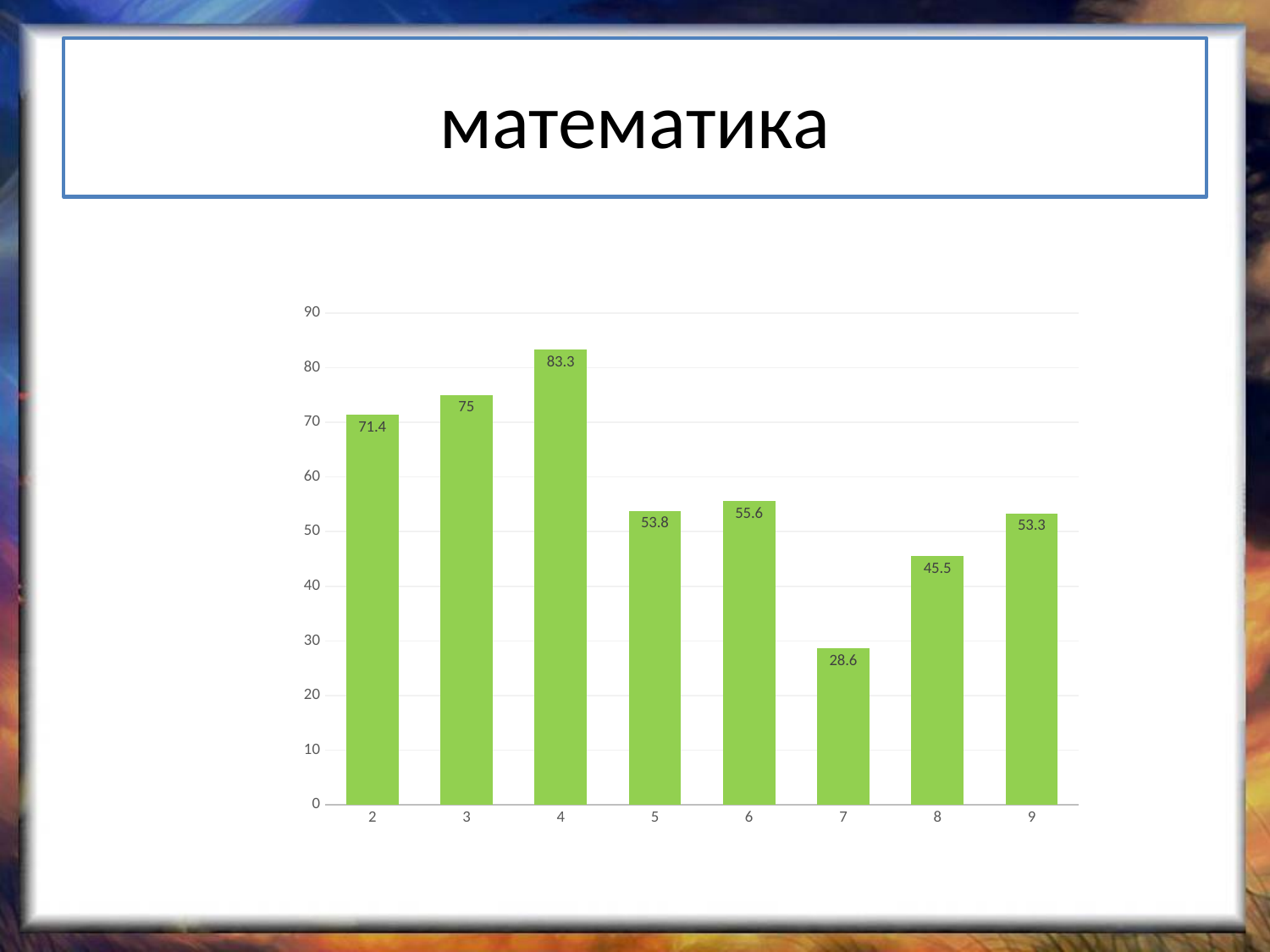
What is the value for category 7? 28.6 Is the value for category 9 greater or less than 50? greater How many categories are shown on the x axis? 8 Which category has the highest value? 4 What is the difference between the values for category 4 and category 7? 54.7 What kind of chart is shown on the slide? bar chart What is the title of the slide? математика What is the value for category 4? 83.3 What is the value for category 8? 45.5 Which is larger, the value for category 6 or the value for category 8? 6 What is the difference between the values for category 3 and category 2? 3.6 Which category has the lowest value? 7